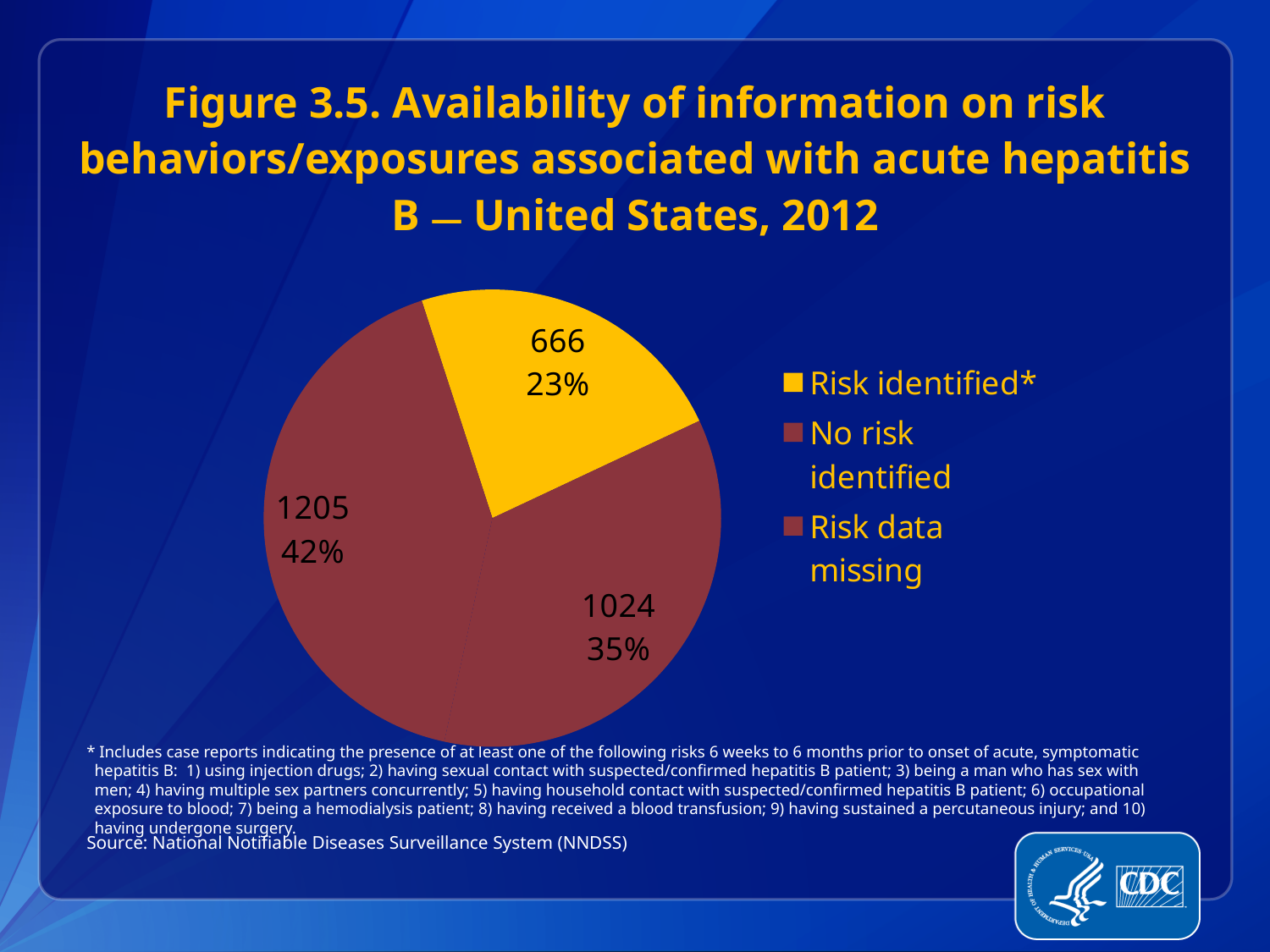
What is the difference between the count on the largest slice (1205) and the 'Risk identified*' count (666)? 539 What share of the pie does the 'Risk identified*' slice represent? 23% How many slices does the pie chart have? 3 How many entries does the legend list? 3 What type of chart is shown on the slide? pie chart Which legend category corresponds to the smallest slice of the pie? Risk identified* What is the count shown on the largest slice of the pie? 1205 What colour is the 'Risk identified*' slice in the pie chart? yellow What is the total number of cases across all three slices of the pie? 2895 What percentage is shown on the largest slice of the pie? 42% Is the 'Risk identified*' slice larger or smaller than the slice labeled 1024? smaller How many cases are in the 'Risk identified*' slice? 666